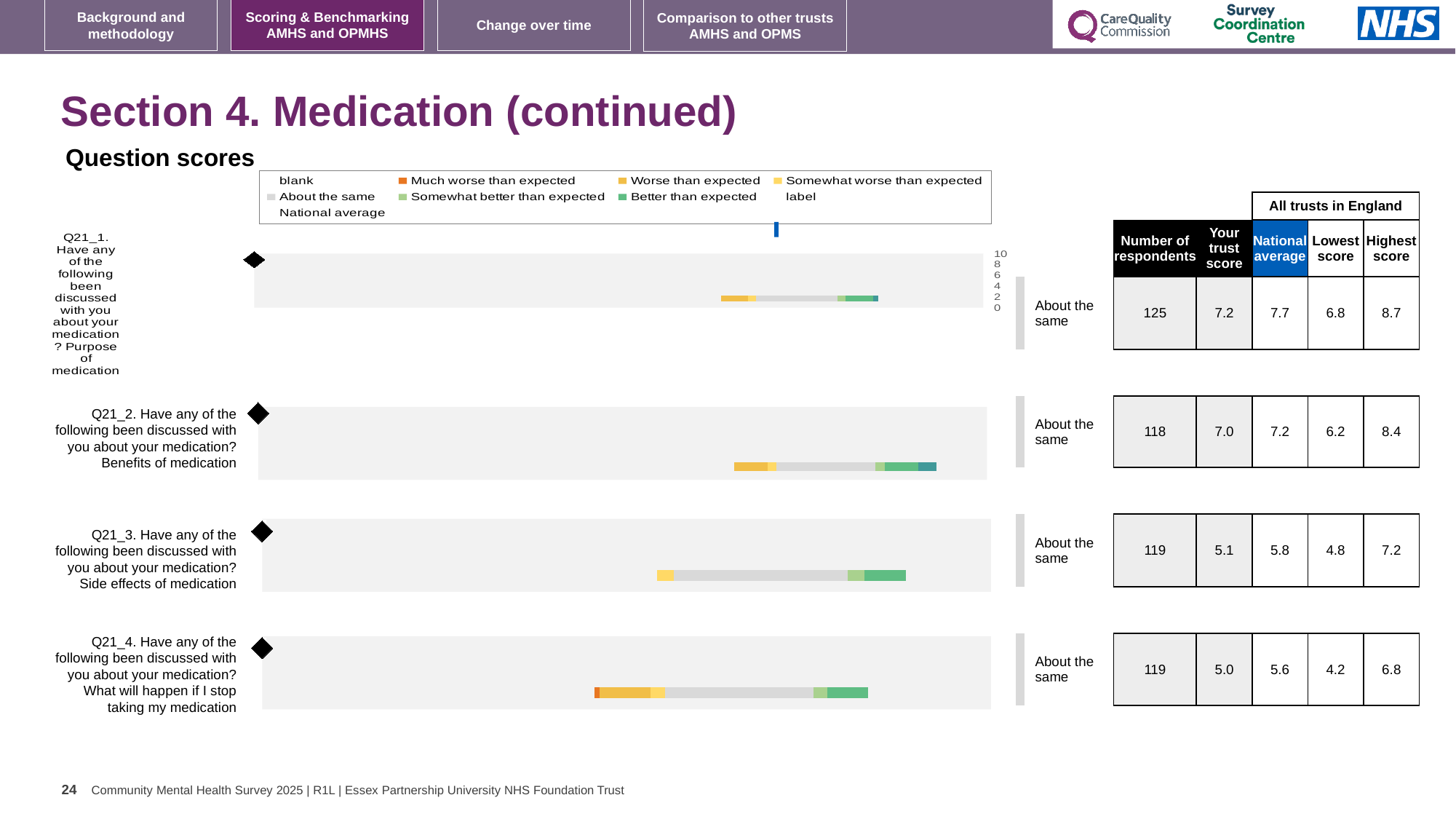
For Q21_1, how much higher is the national average than the trust score? 0.5 What benchmark category is shown next to each of the four charts? About the same How many respondents answered Q21_1? 125 What is the trust score for Q21_2 (Benefits of medication)? 7.0 Which question has the lowest trust score? Q21_4 (What will happen if I stop taking my medication) What is the highest score across all trusts in England for Q21_4? 6.8 For Q21_2, which is larger: the trust score or the national average? National average What kind of chart is used to show the question scores on this slide? bar chart What is the lowest score across all trusts in England for Q21_3? 4.8 Which question has the highest trust score? Q21_1 (Purpose of medication) How many questions (Q21_1 to Q21_4) have a chart on this slide? 4 What is the national average for Q21_3 (Side effects of medication)? 5.8